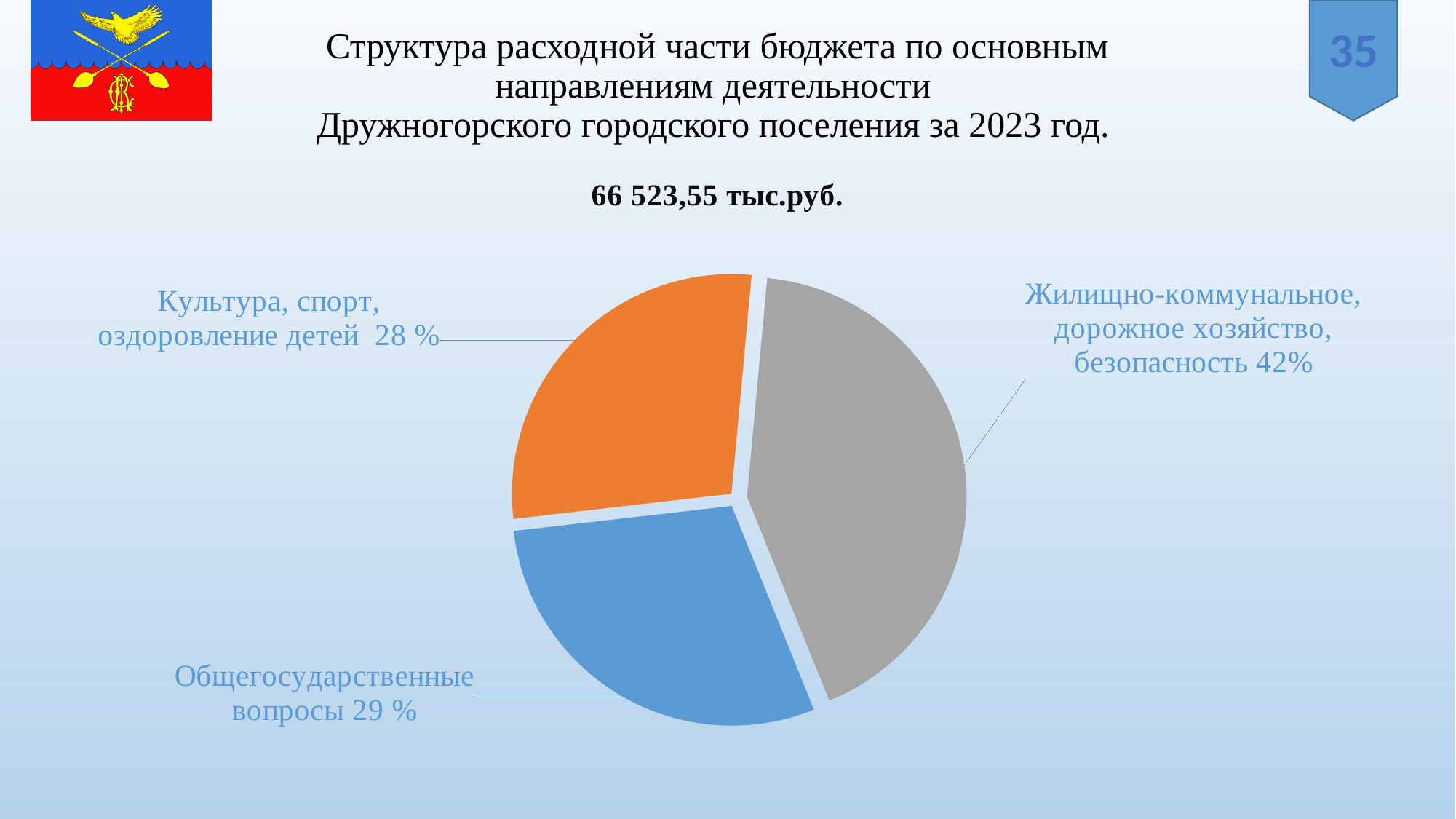
What total amount is printed above the pie chart? 66 523,55 тыс.руб. What type of chart is shown on the slide? pie chart What colour is the slice for Общегосударственные вопросы? blue What share of the pie is labelled for Общегосударственные вопросы? 29 % What is the difference in percentage points between the Жилищно-коммунальное, дорожное хозяйство, безопасность slice and the Культура, спорт, оздоровление детей slice? 14 What share of the pie is labelled for Культура, спорт, оздоровление детей? 28 % What is the difference in percentage points between the Общегосударственные вопросы slice and the Культура, спорт, оздоровление детей slice? 1 Which is larger: the slice for Жилищно-коммунальное, дорожное хозяйство, безопасность or the slice for Общегосударственные вопросы? Жилищно-коммунальное, дорожное хозяйство, безопасность What share of the pie is labelled for Жилищно-коммунальное, дорожное хозяйство, безопасность? 42% Which category has the largest slice of the pie? Жилищно-коммунальное, дорожное хозяйство, безопасность How many slices does the pie chart have? 3 Which category has the smallest slice of the pie? Культура, спорт, оздоровление детей